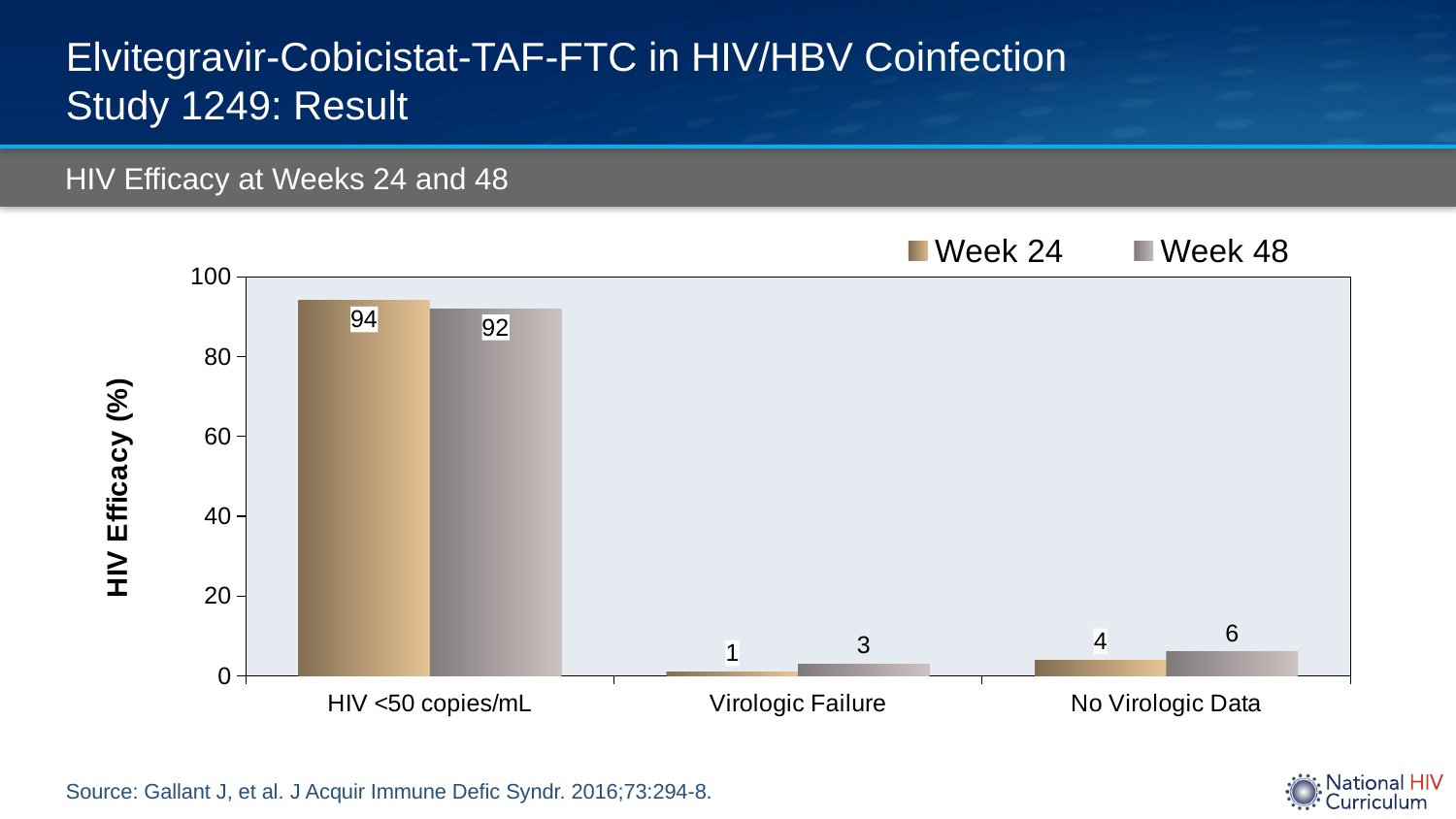
Which is larger for No Virologic Data, the Week 24 value or the Week 48 value? Week 48 What is the Week 48 value for Virologic Failure? 3 What is the Week 24 value for No Virologic Data? 4 Is the Week 48 value for HIV <50 copies/mL greater or less than 80? greater What is the difference between the Week 24 and Week 48 values for HIV <50 copies/mL? 2 What is the Week 24 value for HIV <50 copies/mL? 94 Which category has the highest Week 48 value? HIV <50 copies/mL What is the label of the y axis? HIV Efficacy (%) What kind of chart is shown on the slide? Bar chart How many categories are shown on the x axis? 3 How many series does the legend list? 2 Which category has the lowest Week 24 value? Virologic Failure